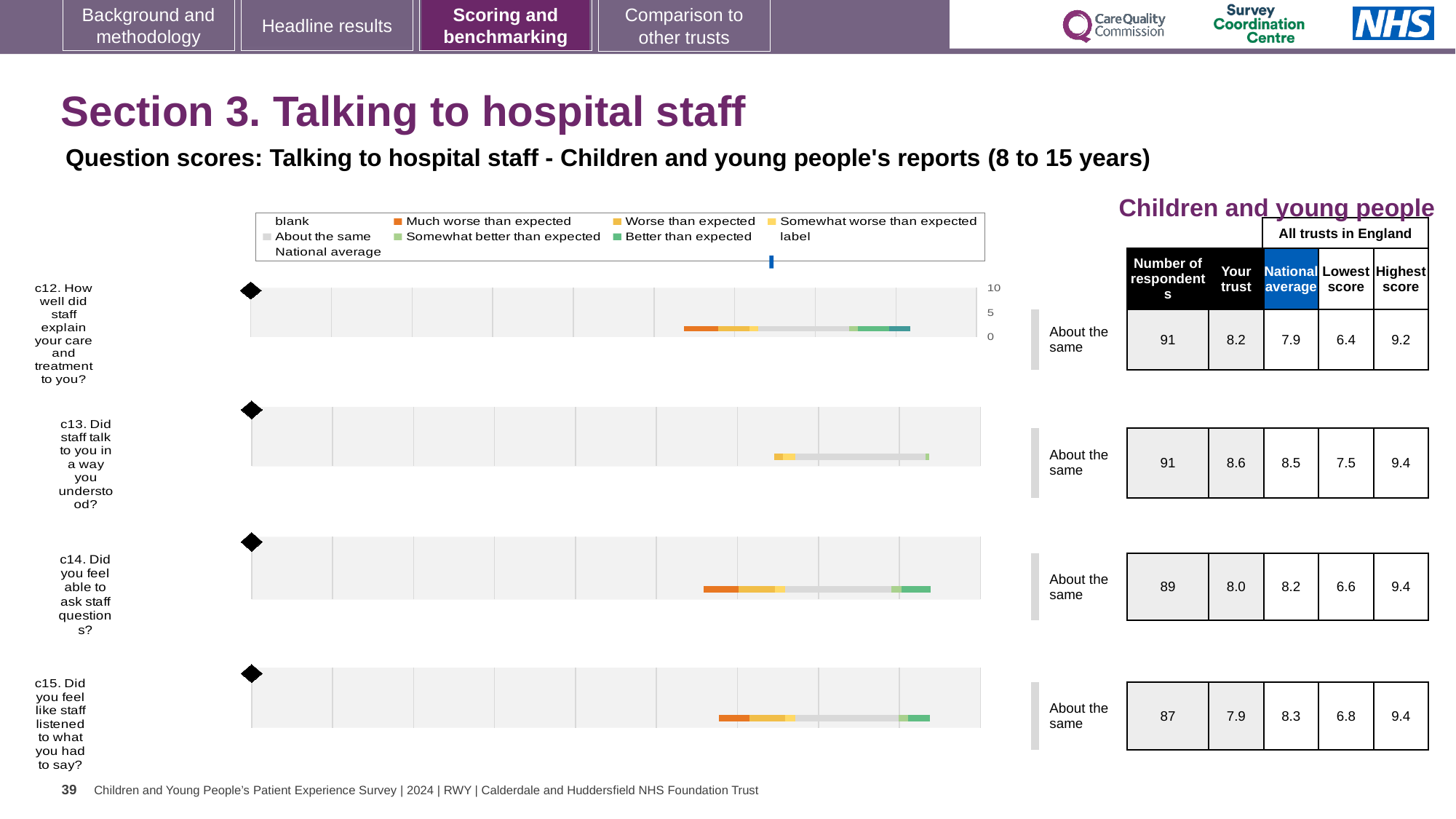
What benchmark category is shown for c12? About the same What is the 'Your trust' score for c13 (Did staff talk to you in a way you understood?)? 8.6 What is the highest score across all trusts in England for c12 (How well did staff explain your care and treatment to you?)? 9.2 For c14, which is larger: the 'Your trust' score or the national average? National average How many survey questions (c12 to c15) are plotted on the slide? 4 What kind of chart is used to show the question scores for c12 to c15? bar chart What is the national average score for c15 (Did you feel like staff listened to what you had to say?)? 8.3 How many respondents answered c14 (Did you feel able to ask staff questions?)? 89 Which question has the lowest 'Your trust' score? c15 What is the difference between the 'Your trust' score and the national average for c12? 0.3 Which legend entry is shown in orange? Much worse than expected Which question has the highest 'Your trust' score? c13